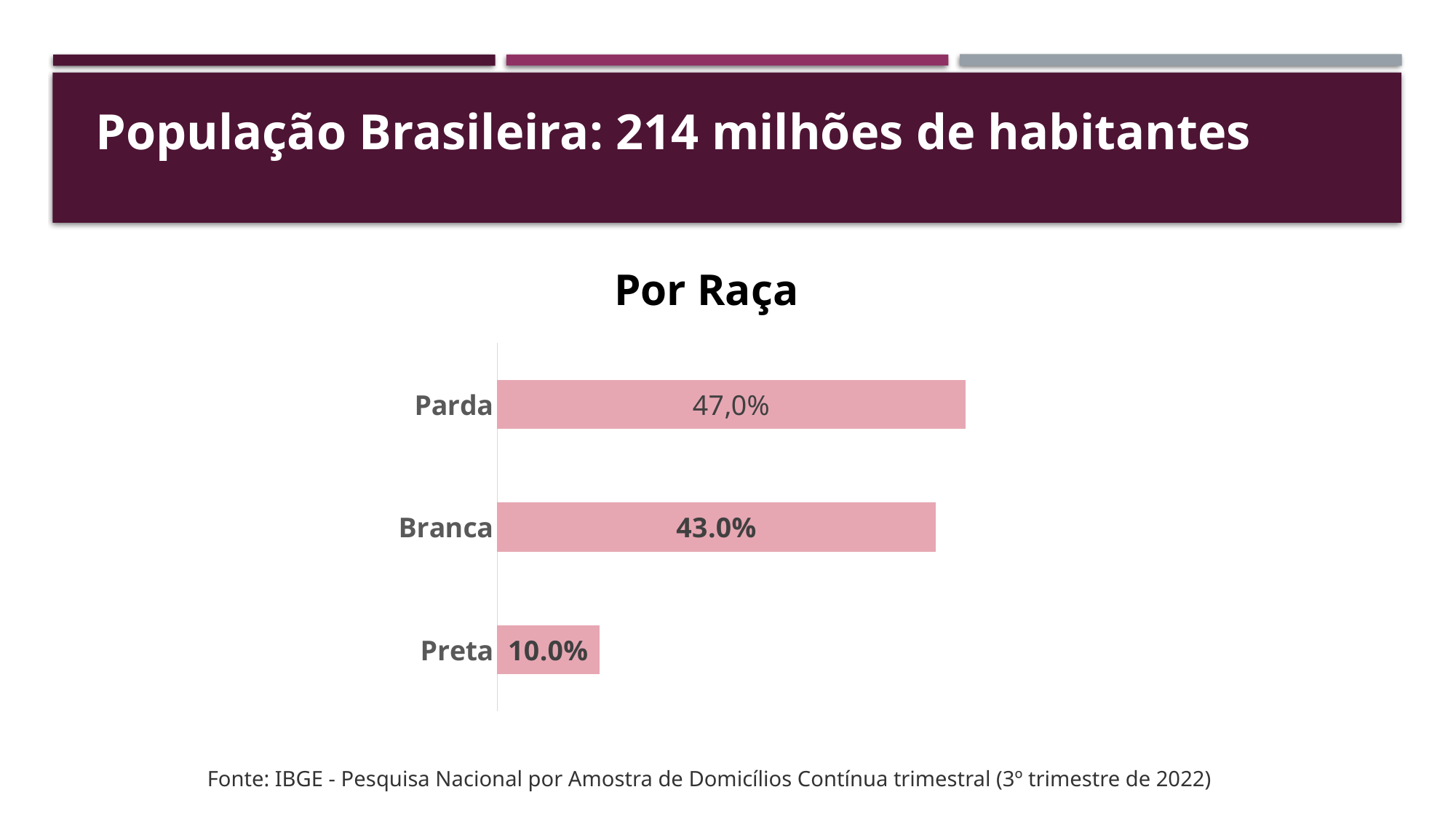
What is the value for Branca? 43.0% What is the difference between the values for Branca and Preta? 33 percentage points How many categories are shown in the chart? 3 What is the value for Preta? 10.0% What is the source cited below the chart? IBGE - Pesquisa Nacional por Amostra de Domicílios Contínua trimestral (3º trimestre de 2022) What kind of chart is shown on the slide? Bar chart Which category has the lowest value? Preta Which is larger, the value for Branca or the value for Preta? Branca What is the difference between the values for Parda and Branca? 4 percentage points What is the title of the chart? Por Raça Which category has the highest value? Parda What is the value for Parda? 47,0%